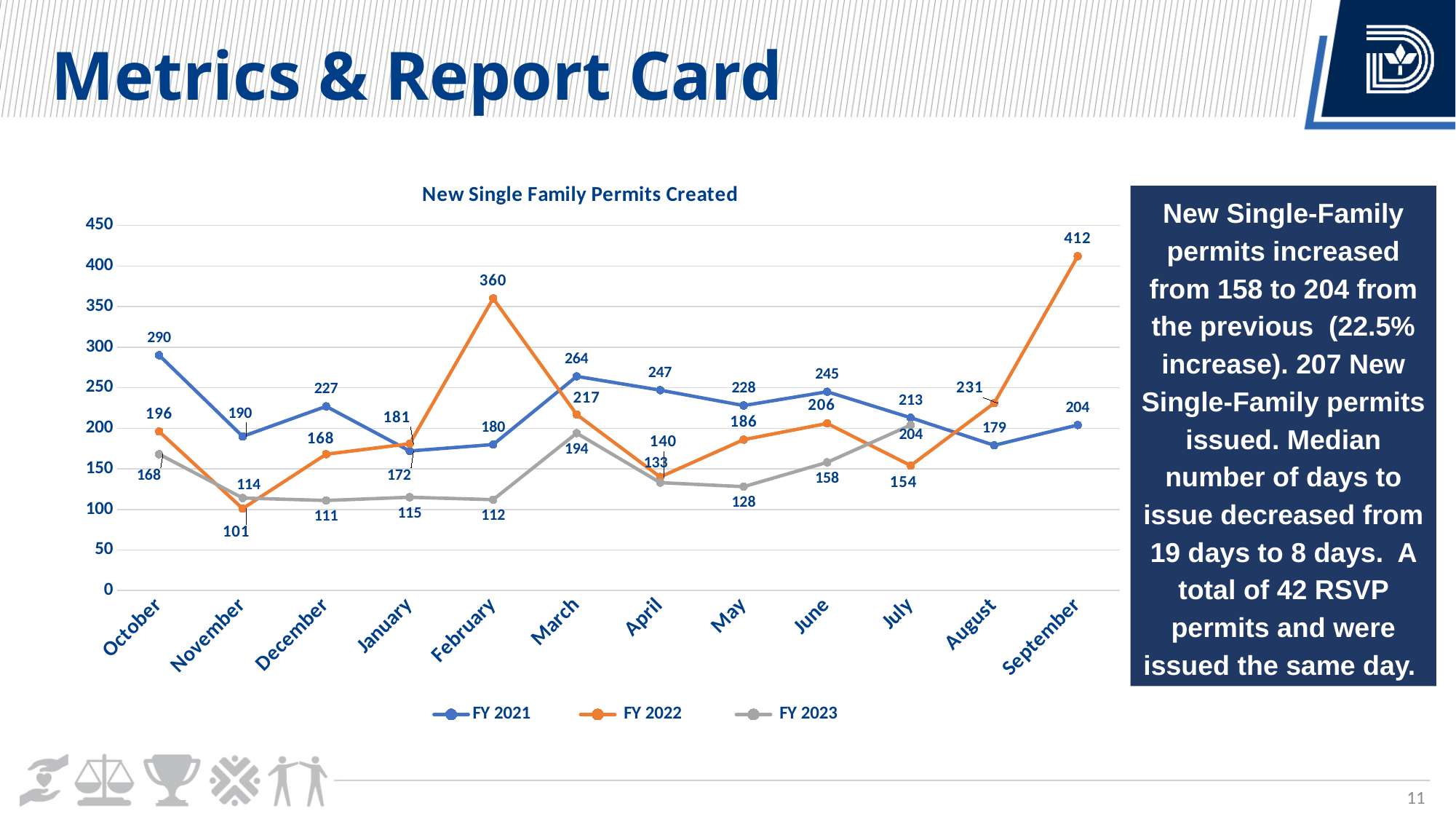
What is the FY 2023 value for March? 194 How many series does the legend list? 3 What is the title of the chart? New Single Family Permits Created In which month is the FY 2022 value highest? September What is the FY 2021 value for October? 290 In February, which series has the larger value, FY 2021 or FY 2022? FY 2022 What kind of chart is shown on the slide? line chart How many months are shown on the x axis? 12 What is the FY 2022 value for September? 412 What is the difference between the FY 2021 values for October and November? 100 Is the FY 2023 value for December greater or less than 150? less In which month is the FY 2022 value lowest? November